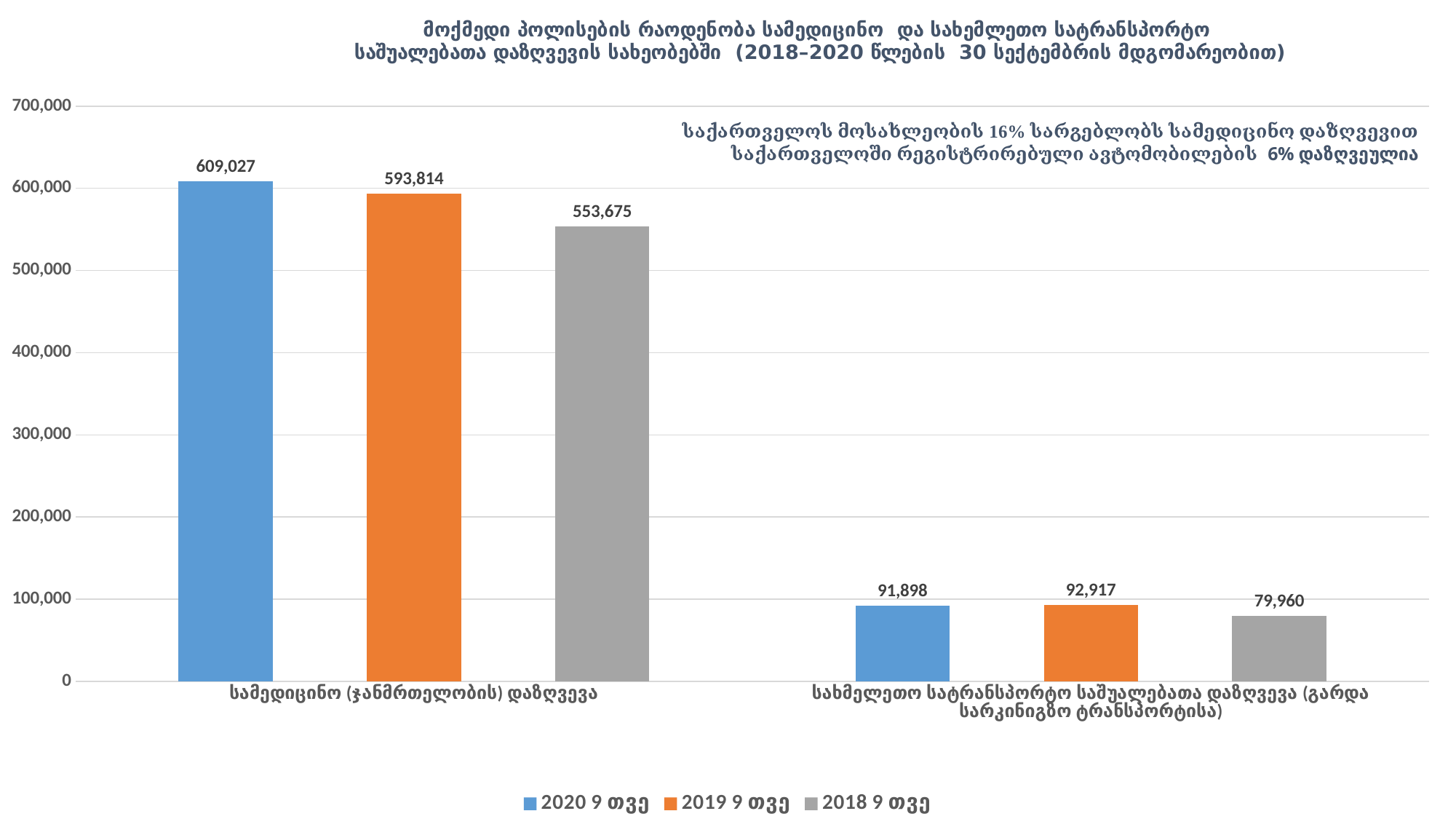
Which series has the highest value for სამედიცინო (ჯანმრთელობის) დაზღვევა? 2020 9 თვე What is the difference between the 2019 9 თვე and 2020 9 თვე values for სახმელეთო სატრანსპორტო საშუალებათა დაზღვევა (გარდა სარკინიგზო ტრანსპორტისა)? 1,019 What is the value for სახმელეთო სატრანსპორტო საშუალებათა დაზღვევა (გარდა სარკინიგზო ტრანსპორტისა) in the 2018 9 თვე series? 79,960 Which series has the lowest value for სახმელეთო სატრანსპორტო საშუალებათა დაზღვევა (გარდა სარკინიგზო ტრანსპორტისა)? 2018 9 თვე What is the value for სამედიცინო (ჯანმრთელობის) დაზღვევა in the 2019 9 თვე series? 593,814 What kind of chart is shown on the slide? bar chart Which colour represents the 2019 9 თვე series? orange What is the value for სახმელეთო სატრანსპორტო საშუალებათა დაზღვევა (გარდა სარკინიგზო ტრანსპორტისა) in the 2019 9 თვე series? 92,917 How many series does the legend list? 3 What is the difference between the 2020 9 თვე and 2018 9 თვე values for სამედიცინო (ჯანმრთელობის) დაზღვევა? 55,352 Is the 2018 9 თვე value for სამედიცინო (ჯანმრთელობის) დაზღვევა greater or less than 500,000? greater What is the value for სამედიცინო (ჯანმრთელობის) დაზღვევა in the 2020 9 თვე series? 609,027